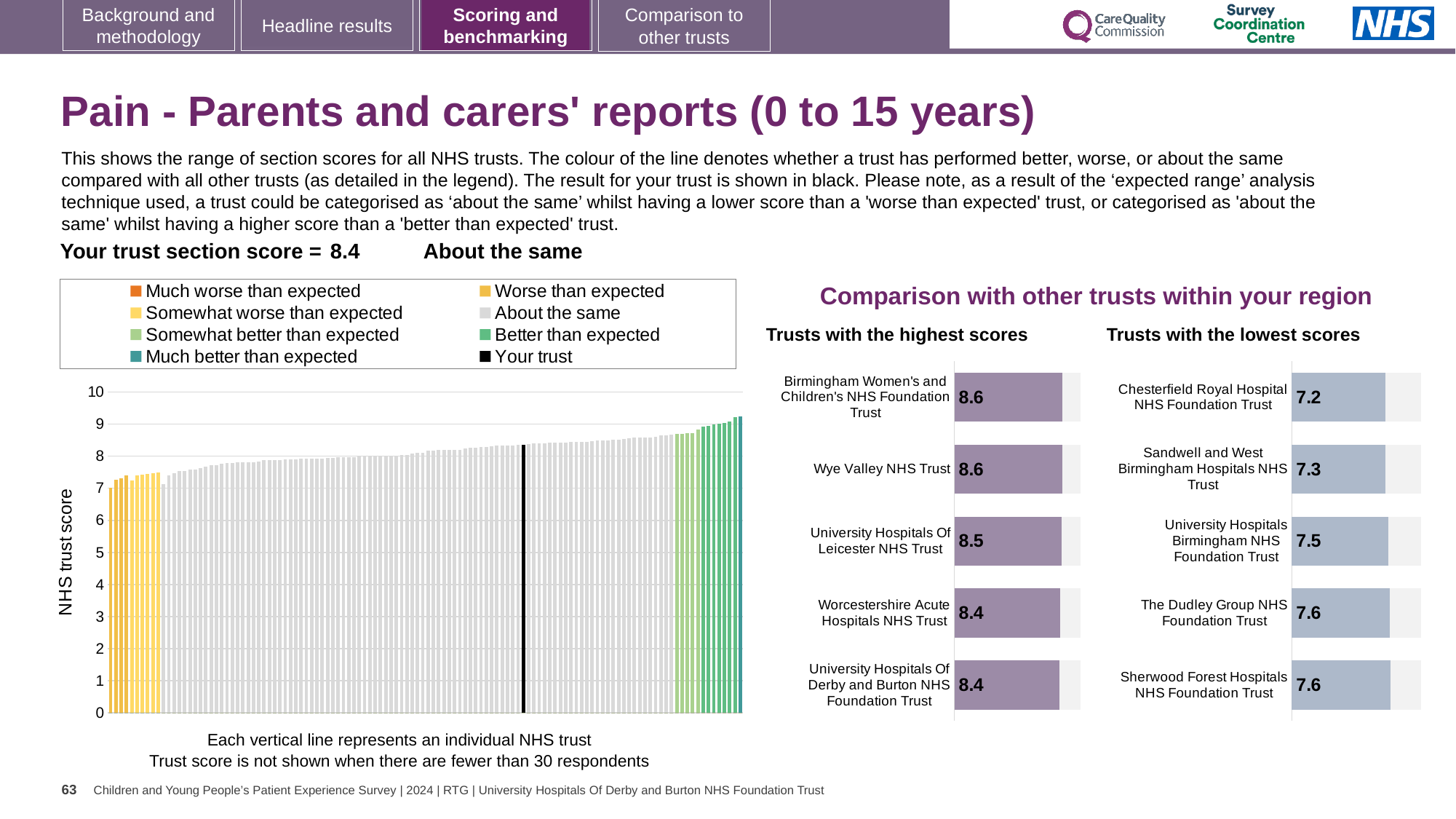
In the main NHS trust score chart, do the bars rise or fall from left to right? Rise What kind of chart is the main chart showing the range of section scores for all NHS trusts? Bar chart In the 'Trusts with the highest scores' chart, what is the difference between the scores of Birmingham Women's and Children's NHS Foundation Trust and Worcestershire Acute Hospitals NHS Trust? 0.2 In the 'Trusts with the lowest scores' chart, which trust has the lowest score? Chesterfield Royal Hospital NHS Foundation Trust In the 'Trusts with the lowest scores' chart, what is the score for Sandwell and West Birmingham Hospitals NHS Trust? 7.3 In the 'Trusts with the highest scores' chart, what is the score for University Hospitals Of Leicester NHS Trust? 8.5 How many entries does the legend of the main NHS trust score chart list? 8 In the 'Trusts with the highest scores' chart, which has the higher score: University Hospitals Of Leicester NHS Trust or Worcestershire Acute Hospitals NHS Trust? University Hospitals Of Leicester NHS Trust In the 'Trusts with the highest scores' chart, what is the score for Wye Valley NHS Trust? 8.6 How many trusts are listed in the 'Trusts with the lowest scores' chart? 5 What is the y-axis label of the main NHS trust score chart? NHS trust score In the 'Trusts with the lowest scores' chart, what is the difference between the scores of Sherwood Forest Hospitals NHS Foundation Trust and Chesterfield Royal Hospital NHS Foundation Trust? 0.4